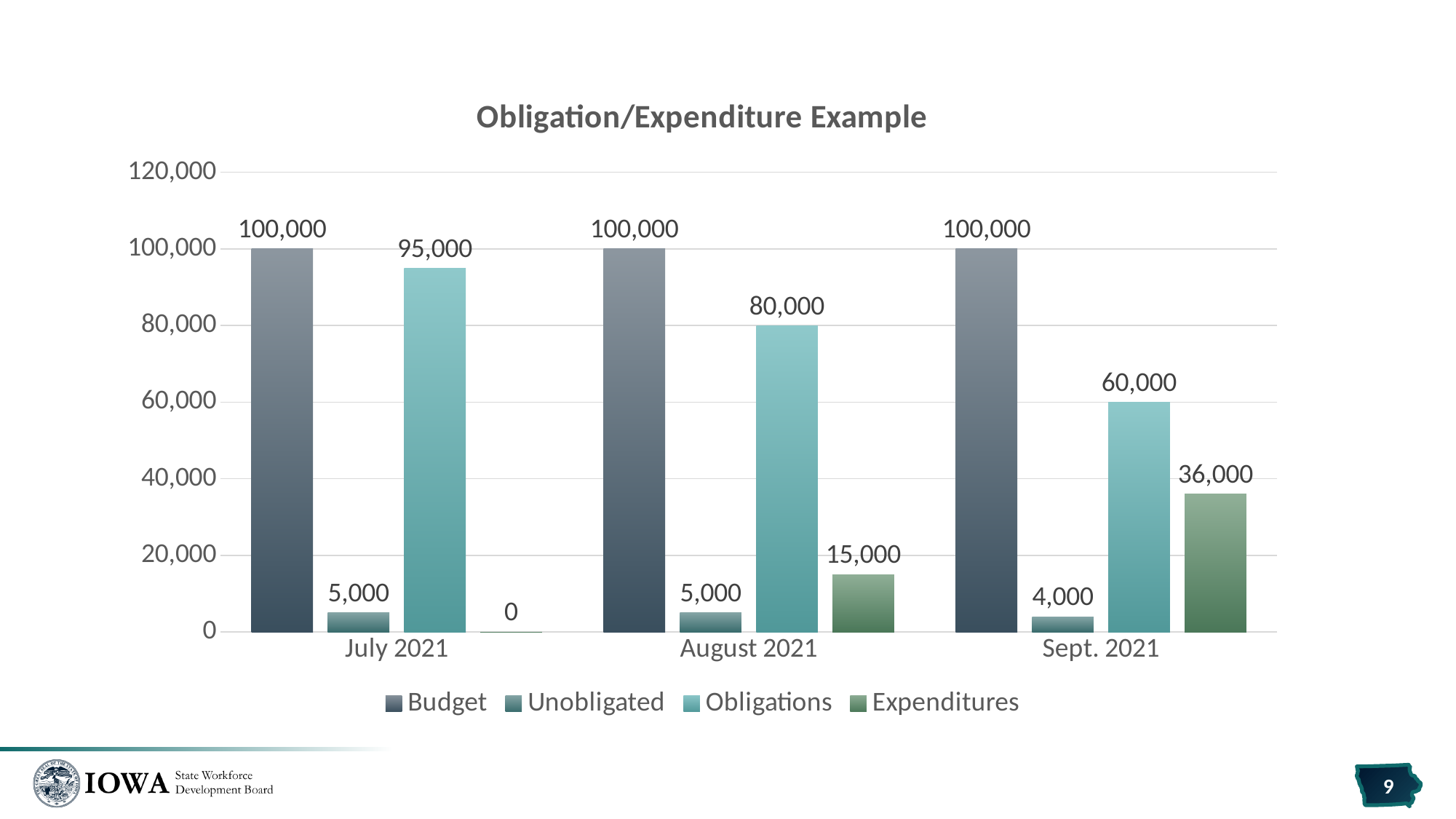
What is the value of Expenditures for Sept. 2021? 36,000 Do the Obligations values rise or fall from July 2021 to Sept. 2021? Fall How many series does the legend list? 4 What is the difference between Obligations and Expenditures in Sept. 2021? 24,000 Which is larger: Expenditures in August 2021 or Expenditures in Sept. 2021? Sept. 2021 What is the Expenditures value for July 2021? 0 In which month is the Obligations value highest? July 2021 How many months are shown on the x axis? 3 In which month is the Unobligated value lowest? Sept. 2021 What is the Unobligated value for July 2021? 5,000 What is the value of Obligations for August 2021? 80,000 What kind of chart is shown on the slide? Bar chart